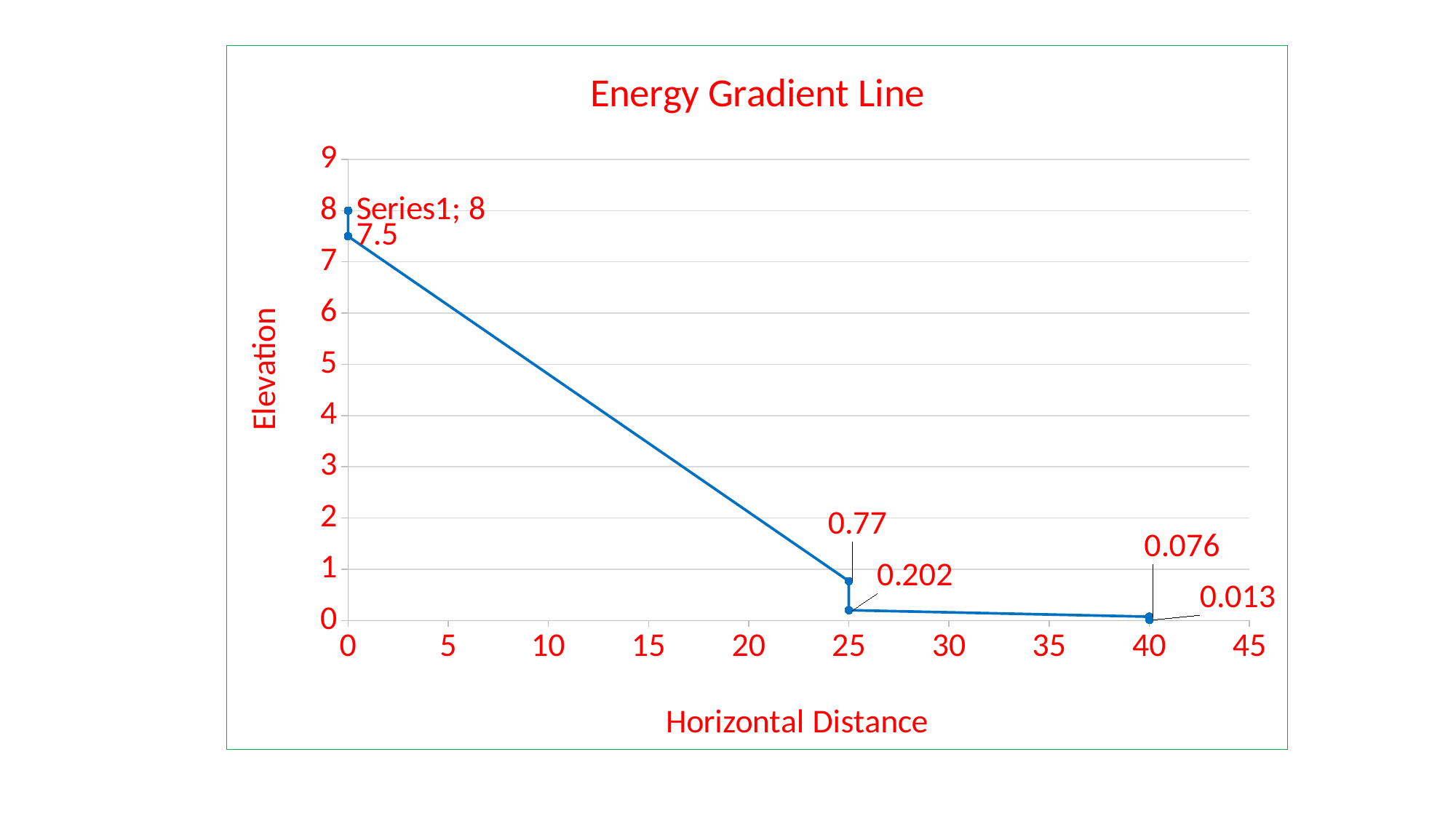
What is the lower elevation value at horizontal distance 25? 0.202 What is the highest elevation value plotted on the chart? 8 Do the elevation values rise or fall as horizontal distance increases? fall What is the lowest elevation value plotted on the chart? 0.013 What is the title of the chart? Energy Gradient Line How many data points are plotted on the line? 6 What is the label of the vertical axis? Elevation Which is larger, the upper elevation at distance 25 or the upper elevation at distance 40? the upper elevation at distance 25 What kind of chart is shown on the slide? line chart What is the upper elevation value at horizontal distance 25? 0.77 What is the difference between the two elevation values at horizontal distance 0 (8 and 7.5)? 0.5 What is the upper elevation value at horizontal distance 40? 0.076